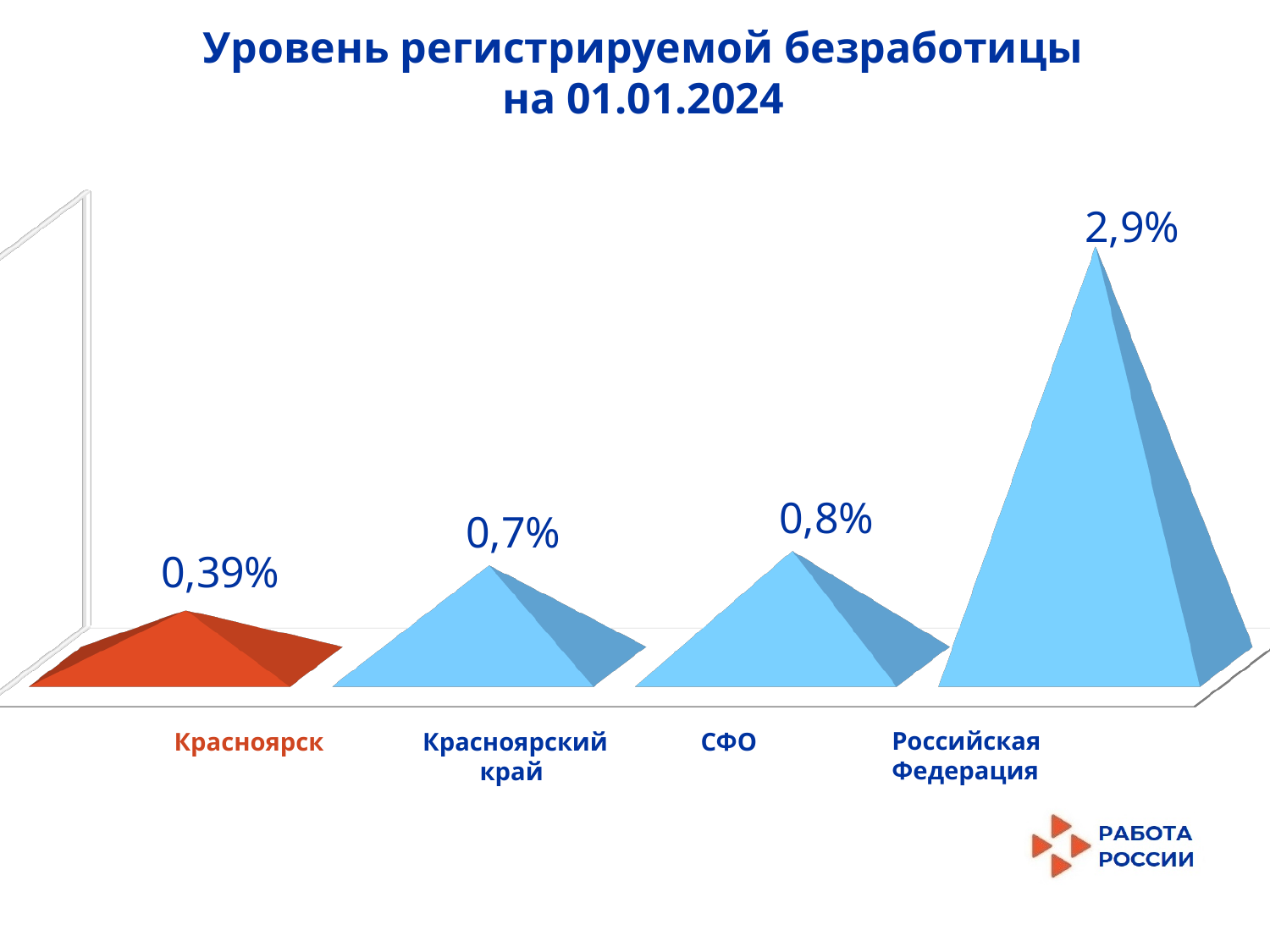
What is the difference between the values for Российская Федерация and СФО? 2,1% What value is shown for СФО? 0,8% Which is larger, the value for СФО or the value for Красноярский край? СФО Which category has the lowest registered unemployment rate? Красноярск What value is shown for Российская Федерация? 2,9% What is the title of the chart? Уровень регистрируемой безработицы на 01.01.2024 Which category has the highest registered unemployment rate? Российская Федерация What is the registered unemployment rate shown for Красноярск? 0,39% Do the values rise or fall from left to right across the categories? rise What is the difference between the values for Красноярский край and Красноярск? 0,31% What value is shown for Красноярский край? 0,7% How many categories are shown on the chart? 4